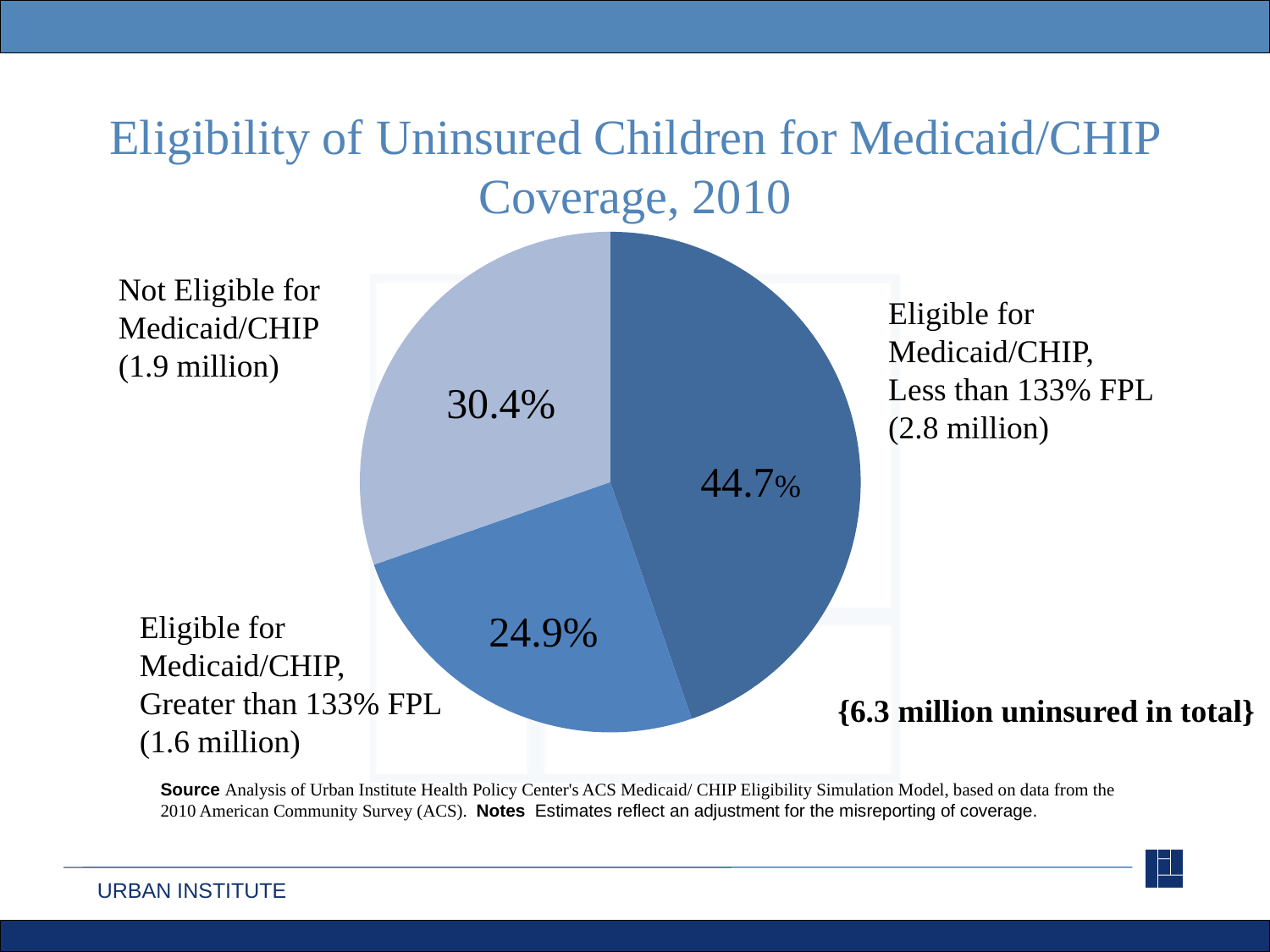
What share of uninsured children are eligible for Medicaid/CHIP at less than 133% FPL? 44.7% Which category has the largest slice of the pie? Eligible for Medicaid/CHIP, Less than 133% FPL What is the difference in percentage points between the 'Less than 133% FPL' slice and the 'Not Eligible' slice? 14.3 What type of chart is shown on the slide? pie chart What share of uninsured children are not eligible for Medicaid/CHIP? 30.4% What share of uninsured children are eligible for Medicaid/CHIP at greater than 133% FPL? 24.9% How many million uninsured children are eligible for Medicaid/CHIP at less than 133% FPL? 2.8 million Which is larger: the share not eligible for Medicaid/CHIP or the share eligible at greater than 133% FPL? Not Eligible for Medicaid/CHIP How many slices does the pie chart have? 3 Which category has the smallest slice of the pie? Eligible for Medicaid/CHIP, Greater than 133% FPL How many uninsured children are there in total according to the slide? 6.3 million What is the title of the chart? Eligibility of Uninsured Children for Medicaid/CHIP Coverage, 2010